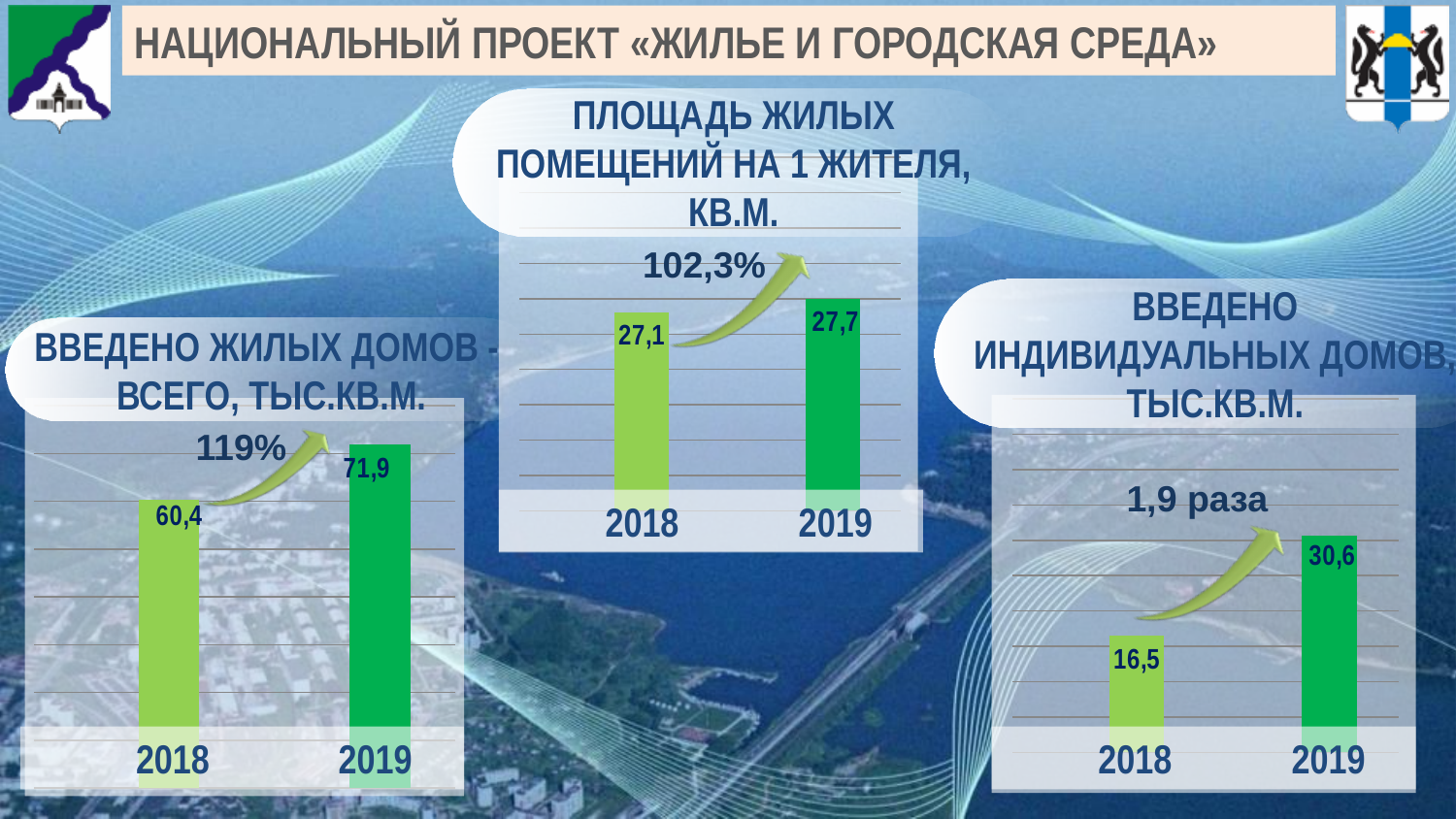
In the left chart (ВВЕДЕНО ЖИЛЫХ ДОМОВ - ВСЕГО, ТЫС.КВ.М.), what is the value for 2019? 71,9 In the left chart (ВВЕДЕНО ЖИЛЫХ ДОМОВ - ВСЕГО, ТЫС.КВ.М.), what is the value for 2018? 60,4 In the middle chart (ПЛОЩАДЬ ЖИЛЫХ ПОМЕЩЕНИЙ НА 1 ЖИТЕЛЯ, КВ.М.), what is the value for 2018? 27,1 How many years (categories) are shown in the middle chart (ПЛОЩАДЬ ЖИЛЫХ ПОМЕЩЕНИЙ НА 1 ЖИТЕЛЯ, КВ.М.)? 2 In the left chart (ВВЕДЕНО ЖИЛЫХ ДОМОВ - ВСЕГО, ТЫС.КВ.М.), what is the difference between the 2019 and 2018 values? 11,5 In the right chart (ВВЕДЕНО ИНДИВИДУАЛЬНЫХ ДОМОВ, ТЫС.КВ.М.), what is the value for 2018? 16,5 What kind of chart is the left chart (ВВЕДЕНО ЖИЛЫХ ДОМОВ - ВСЕГО, ТЫС.КВ.М.)? Bar chart In the right chart (ВВЕДЕНО ИНДИВИДУАЛЬНЫХ ДОМОВ, ТЫС.КВ.М.), what is the difference between the 2019 and 2018 values? 14,1 In the right chart (ВВЕДЕНО ИНДИВИДУАЛЬНЫХ ДОМОВ, ТЫС.КВ.М.), what is the value for 2019? 30,6 In the right chart (ВВЕДЕНО ИНДИВИДУАЛЬНЫХ ДОМОВ, ТЫС.КВ.М.), which year has the higher value? 2019 In the middle chart (ПЛОЩАДЬ ЖИЛЫХ ПОМЕЩЕНИЙ НА 1 ЖИТЕЛЯ, КВ.М.), what is the value for 2019? 27,7 In the middle chart (ПЛОЩАДЬ ЖИЛЫХ ПОМЕЩЕНИЙ НА 1 ЖИТЕЛЯ, КВ.М.), what percentage is shown next to the arrow? 102,3%